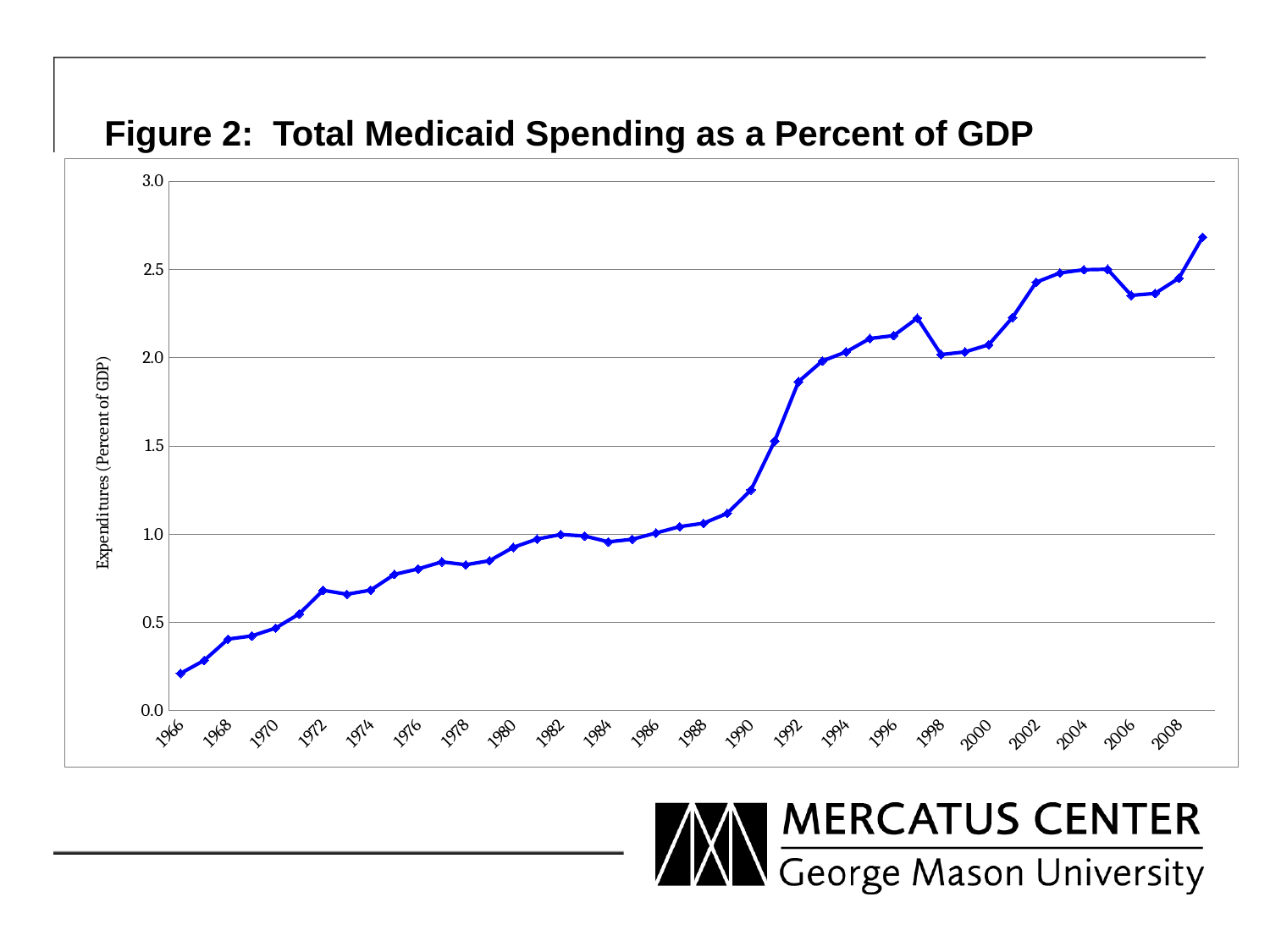
Which year has the lowest value on the chart? 1966 Is the value for 2006 greater or less than 2.5? less What is the title of the chart? Figure 2: Total Medicaid Spending as a Percent of GDP What kind of chart is shown on the slide? Line chart Is the value for 1972 greater or less than 0.5? greater Which year has the larger value, 1988 or 1992? 1992 Which year has the larger value, 2004 or 2006? 2004 Is the value for 1990 greater or less than 1.0? greater Overall, do the values rise or fall from 1966 to the end of the series? Rise What is the label on the vertical axis? Expenditures (Percent of GDP)